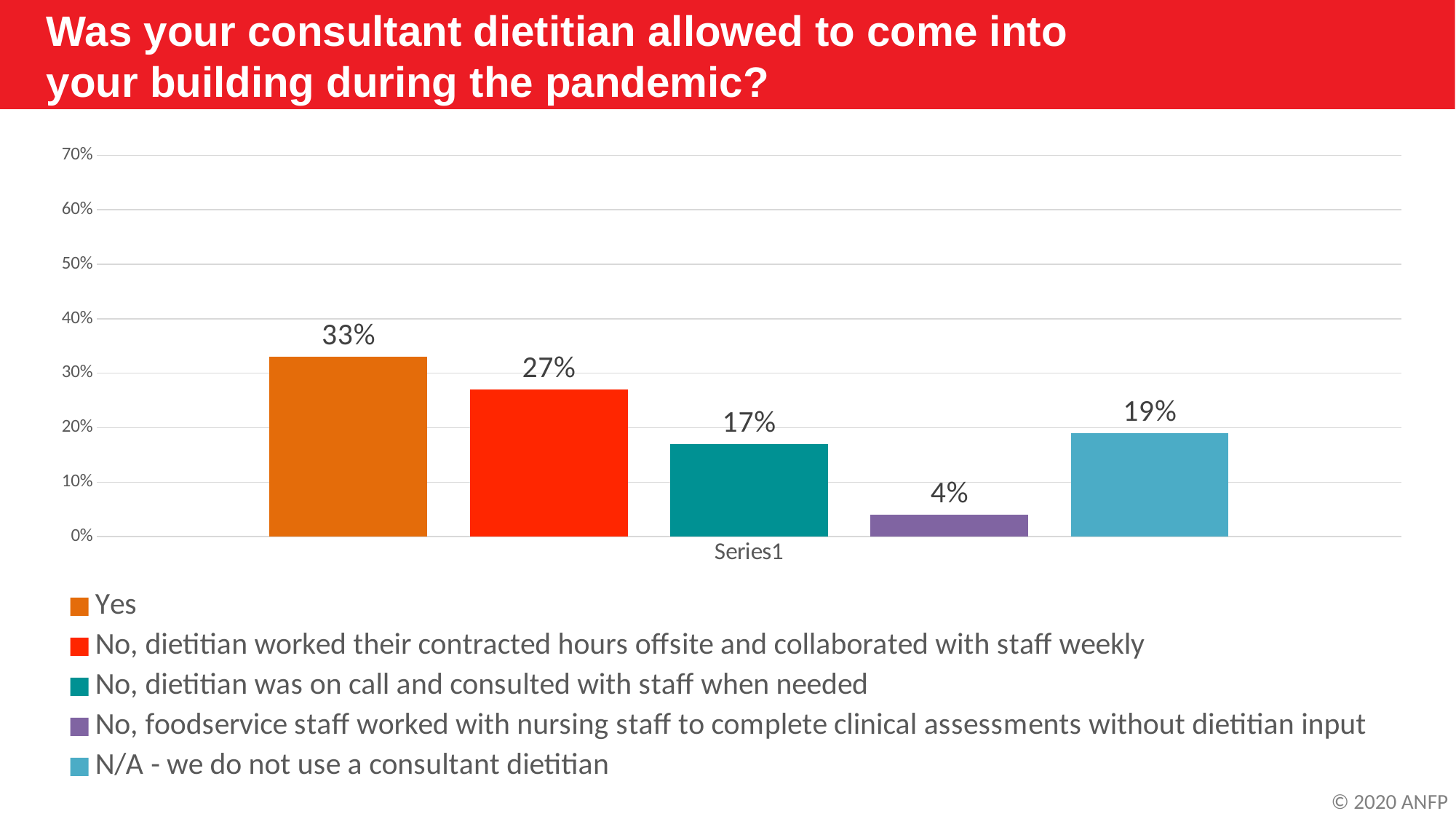
Which is larger: the value for "N/A - we do not use a consultant dietitian" or the value for "No, dietitian was on call and consulted with staff when needed"? N/A - we do not use a consultant dietitian What is the value for "No, dietitian was on call and consulted with staff when needed"? 17% What colour is the bar for "Yes"? Orange How many bars are shown in the chart? 5 What is the difference between the "Yes" value and the "No, dietitian worked their contracted hours offsite and collaborated with staff weekly" value? 6% Which response has the lowest percentage? No, foodservice staff worked with nursing staff to complete clinical assessments without dietitian input What percentage of respondents answered "Yes"? 33% What is the value for "N/A - we do not use a consultant dietitian"? 19% How many entries does the legend list? 5 Is the value for "No, dietitian worked their contracted hours offsite and collaborated with staff weekly" greater or less than 30%? less Which response has the highest percentage? Yes What type of chart is shown on the slide? Bar chart